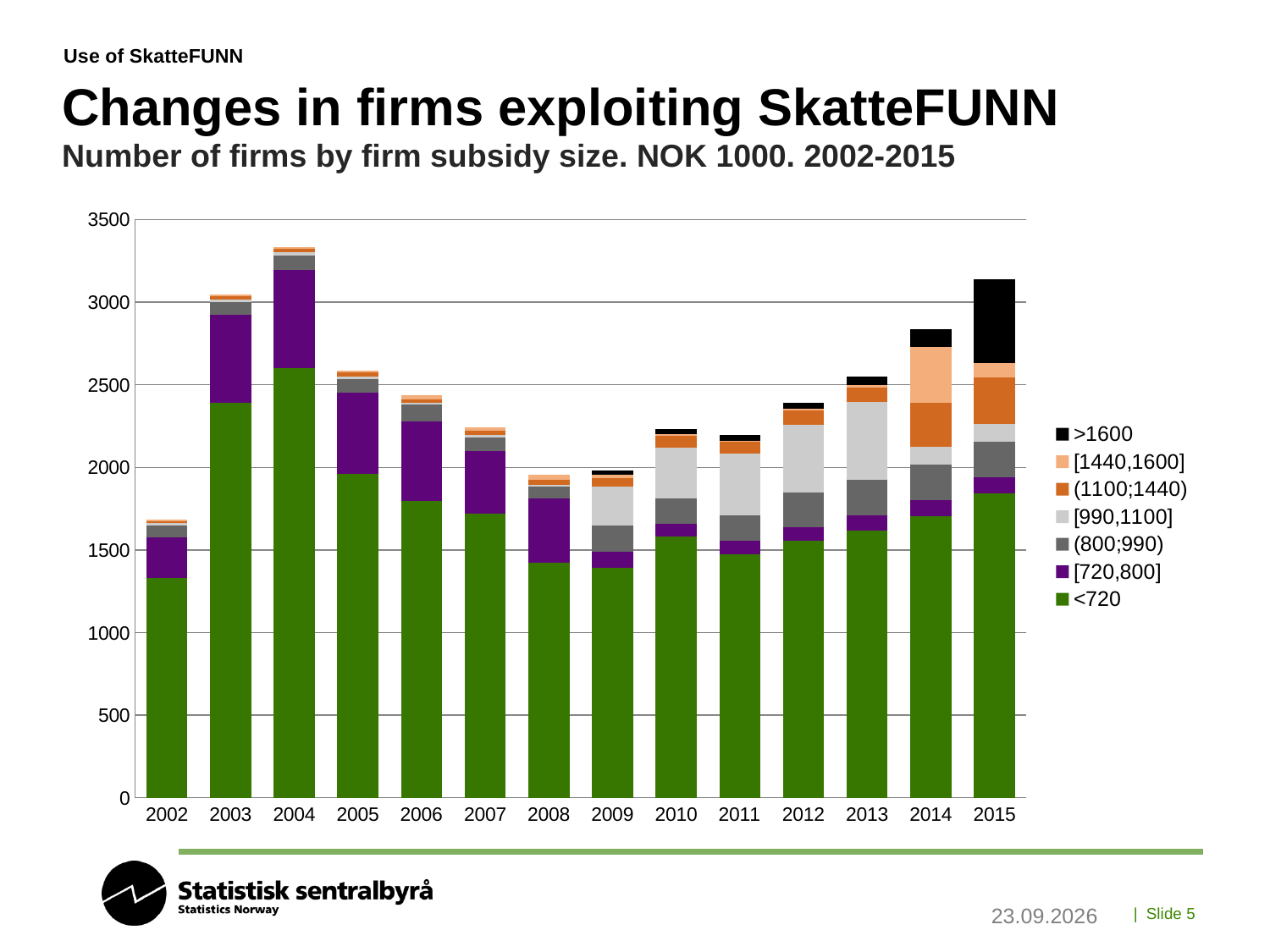
How many series does the legend list? 7 Which year has a larger total bar, 2010 or 2013? 2013 How many years are shown on the x axis of the chart? 14 Which year has the tallest total bar? 2004 Which legend entry is shown in black? >1600 Is the total number of firms in 2015 greater or less than 3000? greater Is the total number of firms in 2014 greater or less than 2500? greater Do the total bar heights rise or fall from 2009 to 2015? rise Which year has the shortest total bar? 2002 Is the total number of firms in 2004 greater or less than 3000? greater What kind of chart is shown on the slide? stacked bar chart